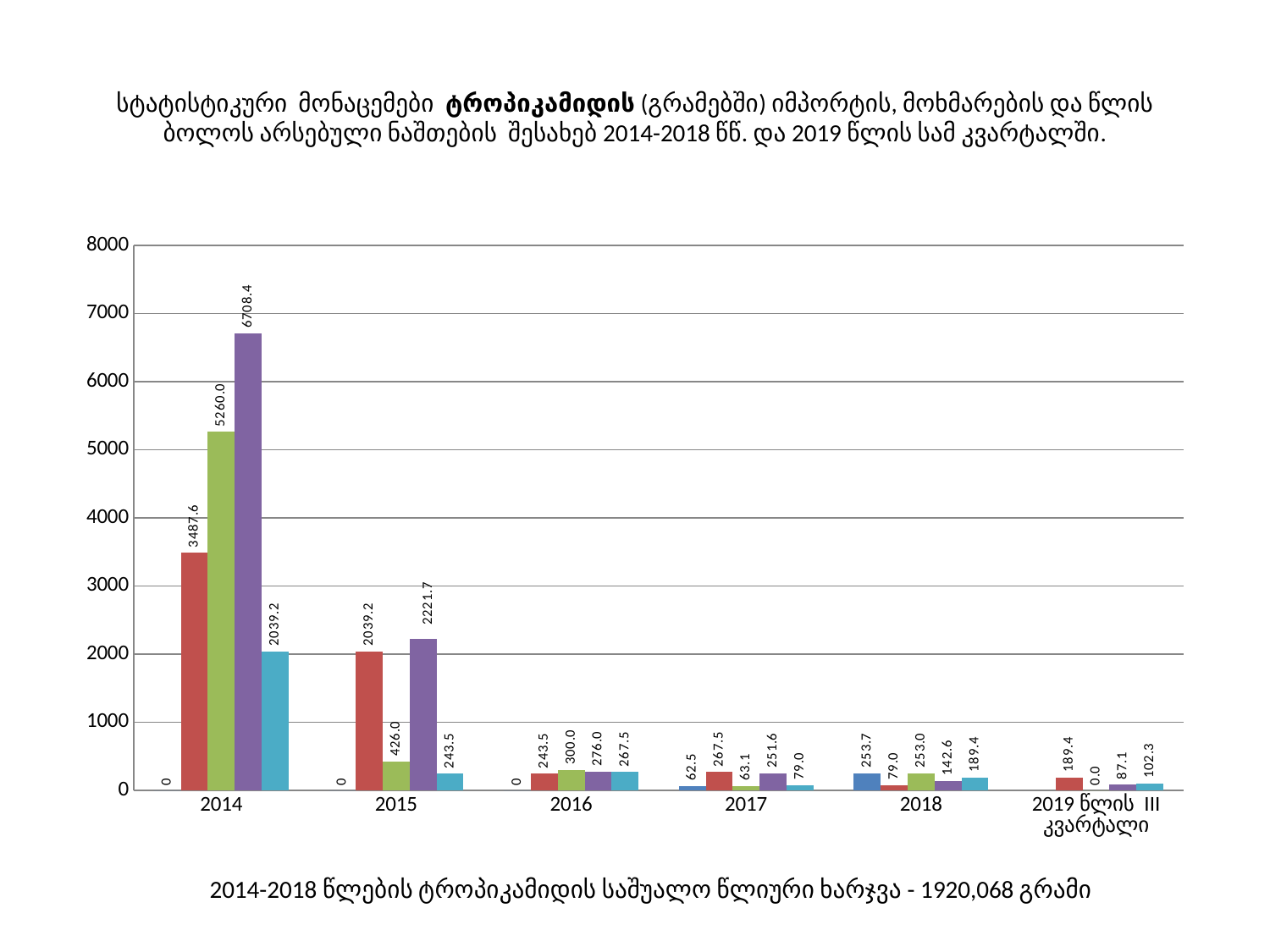
What kind of chart is shown on the slide? bar chart Is the value of the purple bar for 2014 greater or less than 6000? greater For 2016, which is larger: the green bar or the red bar? the green bar (300.0) What is the value of the light blue bar for 2018? 189.4 What is the value of the purple bar for 2017? 251.6 What is the value of the purple bar for 2014? 6708.4 How many categories are shown along the x axis? 6 Which bar is the highest in the whole chart? the purple bar for 2014 (6708.4) What is the value of the green bar for 2015? 426.0 What is the difference between the purple bar and the green bar for 2014? 1448.4 Do the purple bars rise or fall from 2014 to 2016? fall What is the value of the red bar for 2014? 3487.6